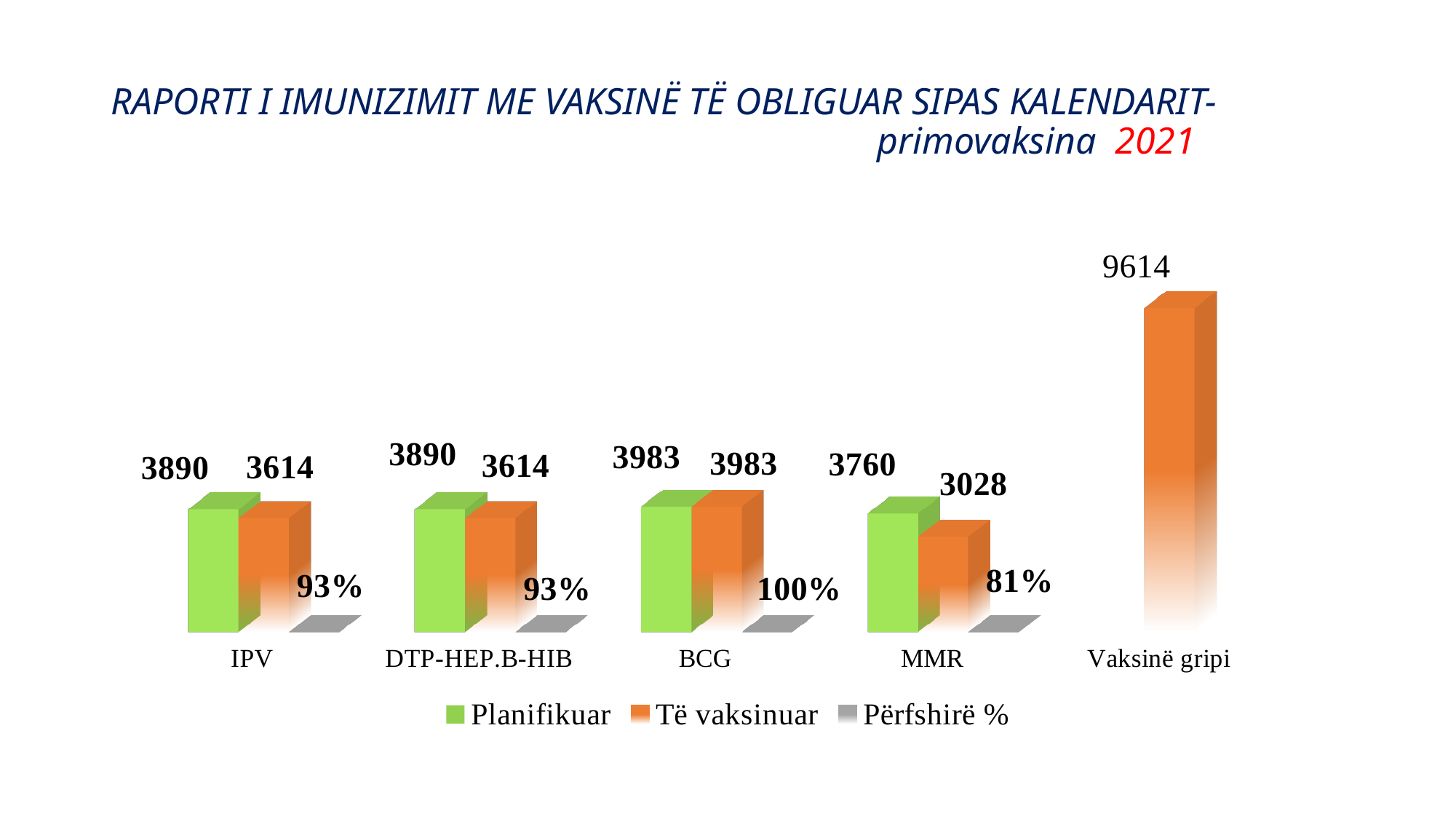
Which category has the lowest Përfshirë % value? MMR Which category has the highest Të vaksinuar value? Vaksinë gripi Which colour represents the Të vaksinuar series? Orange What is the Përfshirë % value for BCG? 100% What is the Të vaksinuar value for Vaksinë gripi? 9614 How many categories are shown on the x axis? 5 What is the Të vaksinuar value for MMR? 3028 What is the Planifikuar value for IPV? 3890 What kind of chart is shown on the slide? Bar chart How many series does the legend list? 3 What is the difference between the Planifikuar and Të vaksinuar values for MMR? 732 Which is larger, the Planifikuar value for BCG or the Planifikuar value for IPV? BCG